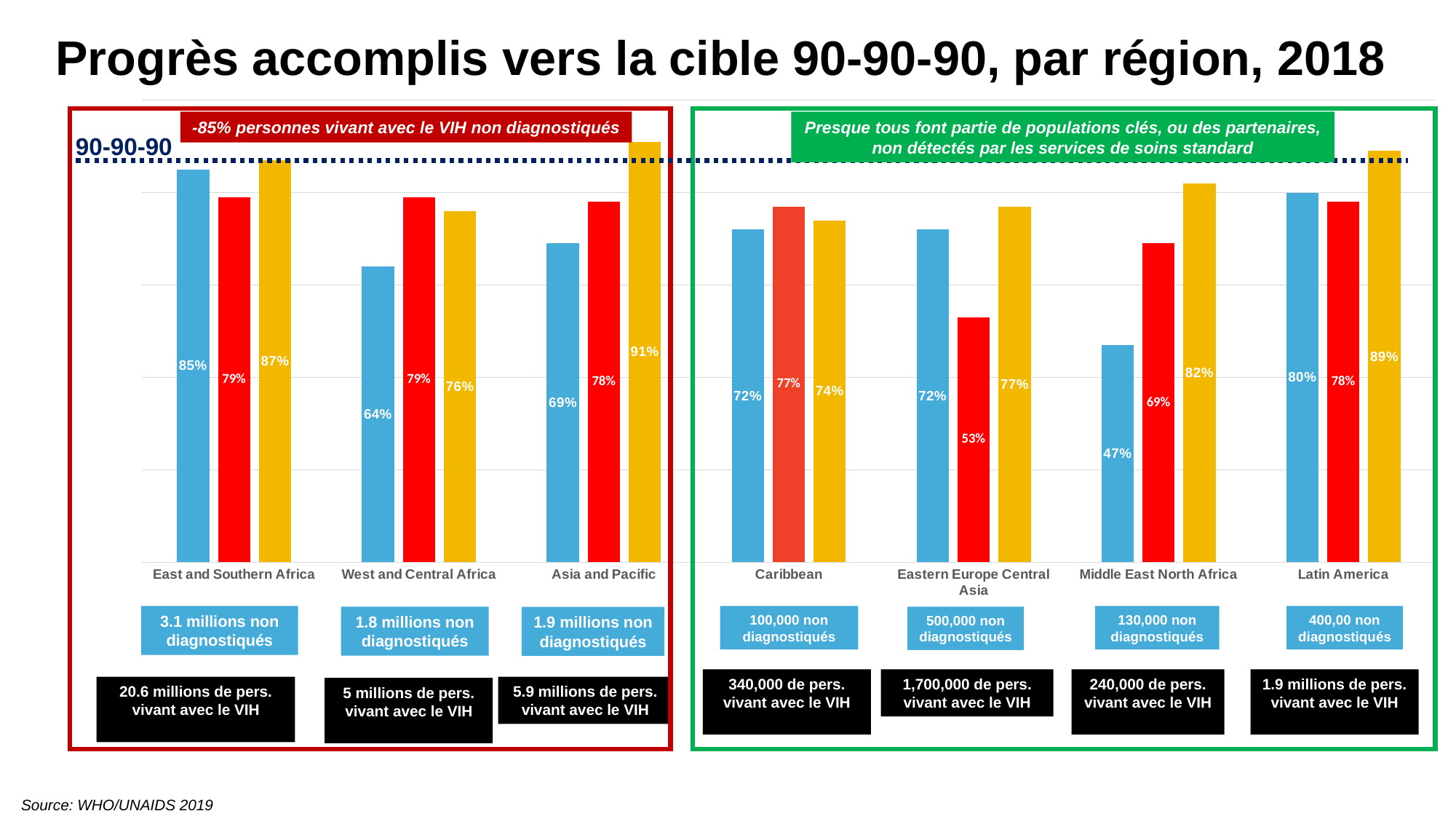
Which region has the highest yellow bar? Asia and Pacific What is the value of the blue bar for East and Southern Africa? 85% Which region has the lowest blue bar? Middle East North Africa Which is larger for Caribbean, the red bar or the yellow bar? the red bar What is the title of the slide? Progrès accomplis vers la cible 90-90-90, par région, 2018 What is the value of the blue bar for Middle East North Africa? 47% What type of chart is shown on the slide? bar chart What is the value of the yellow bar for Asia and Pacific? 91% What is the difference between the yellow bar and the blue bar for Middle East North Africa? 35% What is the value of the red bar for West and Central Africa? 79% How many regions are shown on the x axis of the chart? 7 What is the value of the red bar for Eastern Europe Central Asia? 53%